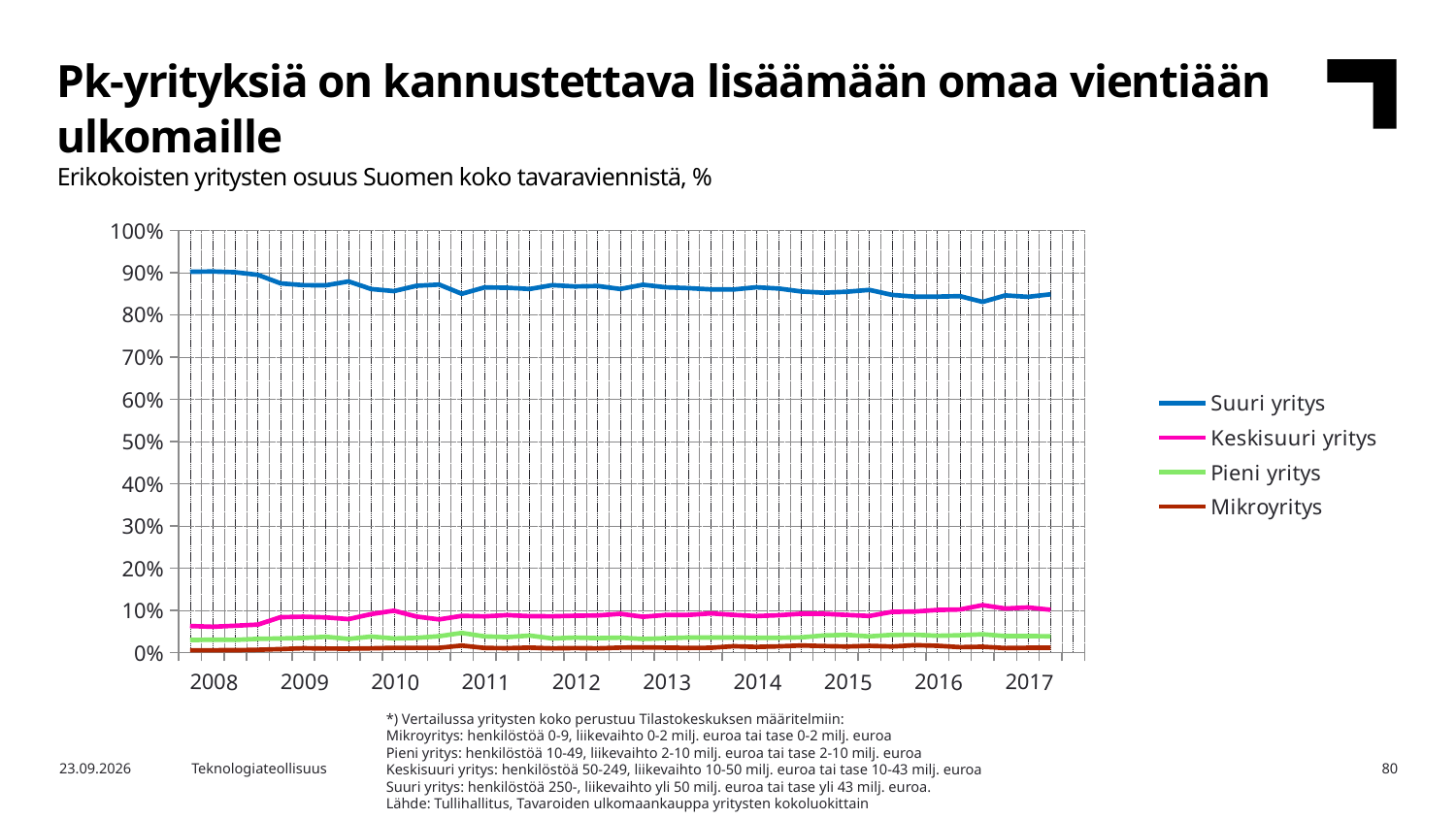
What is the subtitle describing what the chart shows? Erikokoisten yritysten osuus Suomen koko tavaraviennistä, % Does the Suuri yritys line rise or fall from 2008 to 2017? fall Is the value for Suuri yritys in 2008 greater or less than 80%? greater Is the value for Pieni yritys in 2012 greater or less than 10%? less Which series has the highest values throughout the chart? Suuri yritys How many series does the chart legend list? 4 What kind of chart is shown on the slide? line chart How many years are labelled on the x axis of the chart? 10 Which series has the lowest values throughout the chart? Mikroyritys Which is larger in 2015, the value for Suuri yritys or the value for Keskisuuri yritys? Suuri yritys Does the Keskisuuri yritys line rise or fall from 2008 to 2017? rise Is the value for Keskisuuri yritys in 2017 greater or less than 20%? less